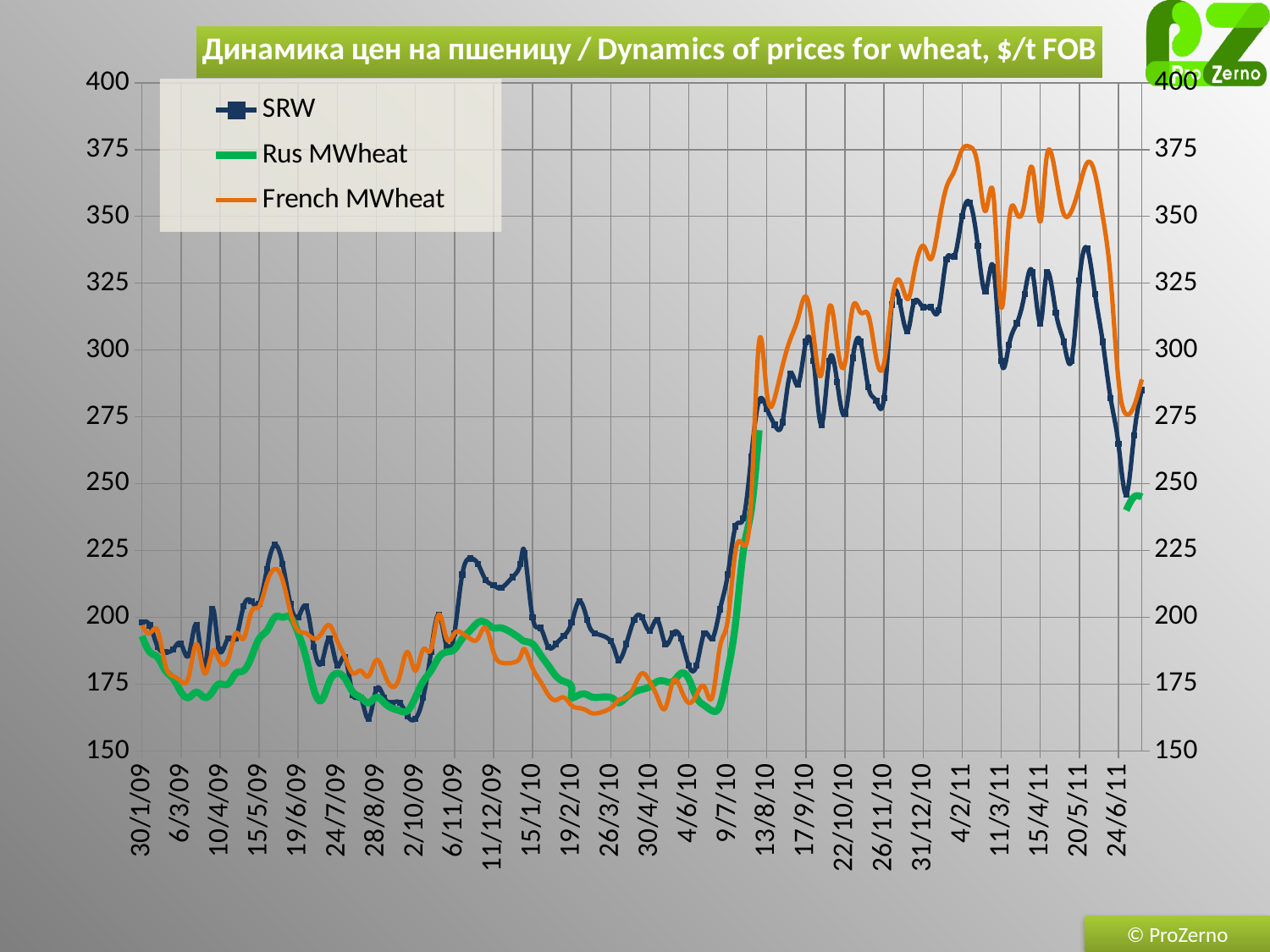
How many series does the legend list? 3 Is the value for French MWheat at 26/3/10 greater or less than 175? less Is the value for SRW at 11/12/09 greater or less than 200? greater At 4/2/11, which is higher: French MWheat or SRW? French MWheat Is the value for Rus MWheat at 30/1/09 greater or less than 200? less Which series reaches the highest value on the chart? French MWheat What kind of chart is shown on the slide? line chart At 11/12/09, which is higher: SRW or Rus MWheat? SRW What is the title of the chart? Динамика цен на пшеницу / Dynamics of prices for wheat, $/t FOB Which series are listed in the legend? SRW, Rus MWheat, French MWheat Does the SRW series rise or fall between 9/7/10 and 13/8/10? rise